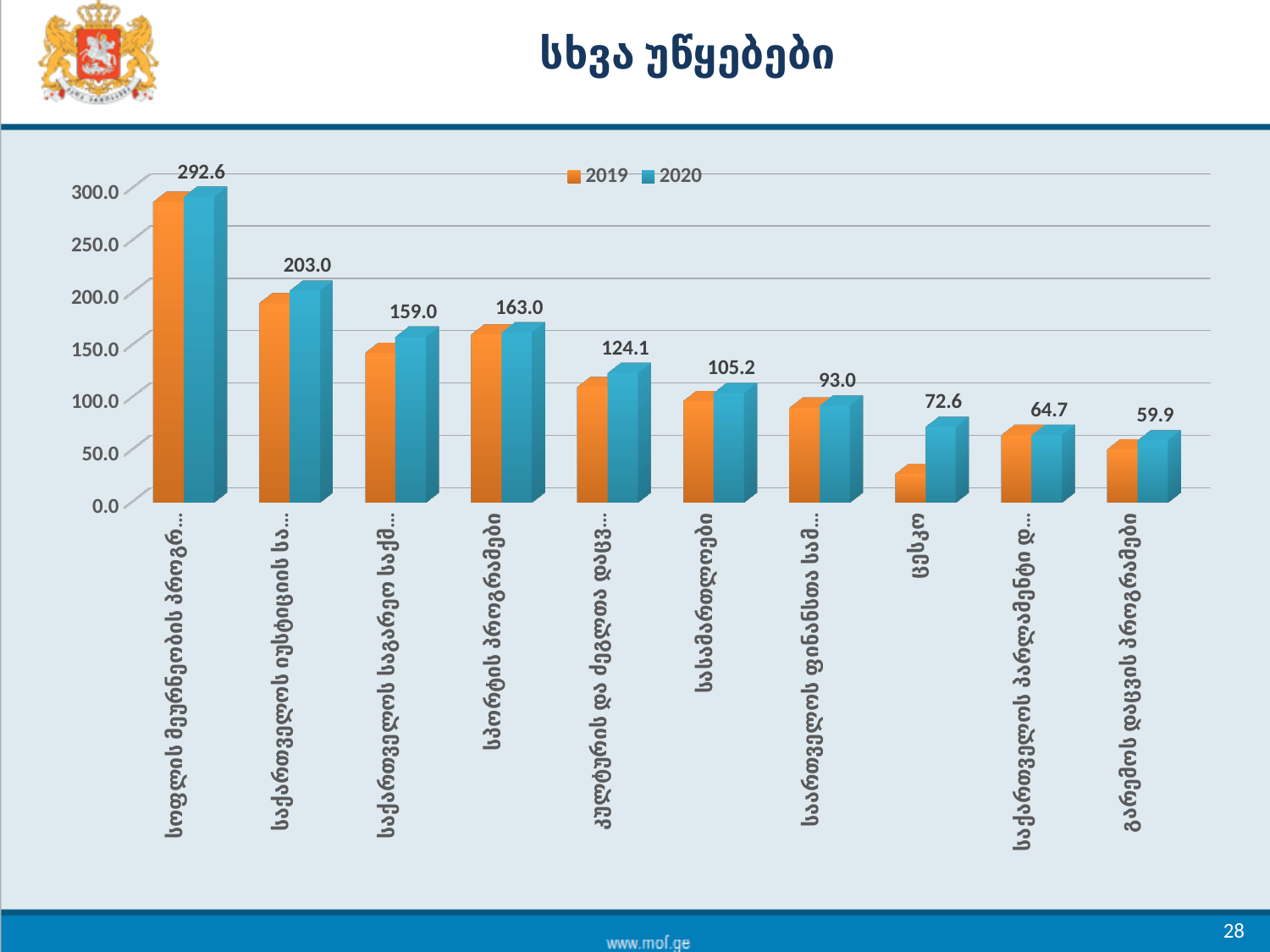
Which category has the lowest labelled value in the chart? გარემოს დაცვის პროგრამები How many categories are shown on the x axis of the chart? 10 Which years are listed in the chart legend? 2019 and 2020 How many series does the legend list? 2 What value is labelled for სასამართლოები? 105.2 What value is labelled for ცესკო? 72.6 Which category has the highest labelled value in the chart? სოფლის მეურნეობის პროგრ... (the first category) What kind of chart is shown on the slide? bar chart What value is labelled for გარემოს დაცვის პროგრამები? 59.9 Is the 2019 value for ცესკო greater or less than 50? less What is the difference between the labelled values for სასამართლოები and ცესკო? 32.6 What value is labelled for სპორტის პროგრამები? 163.0